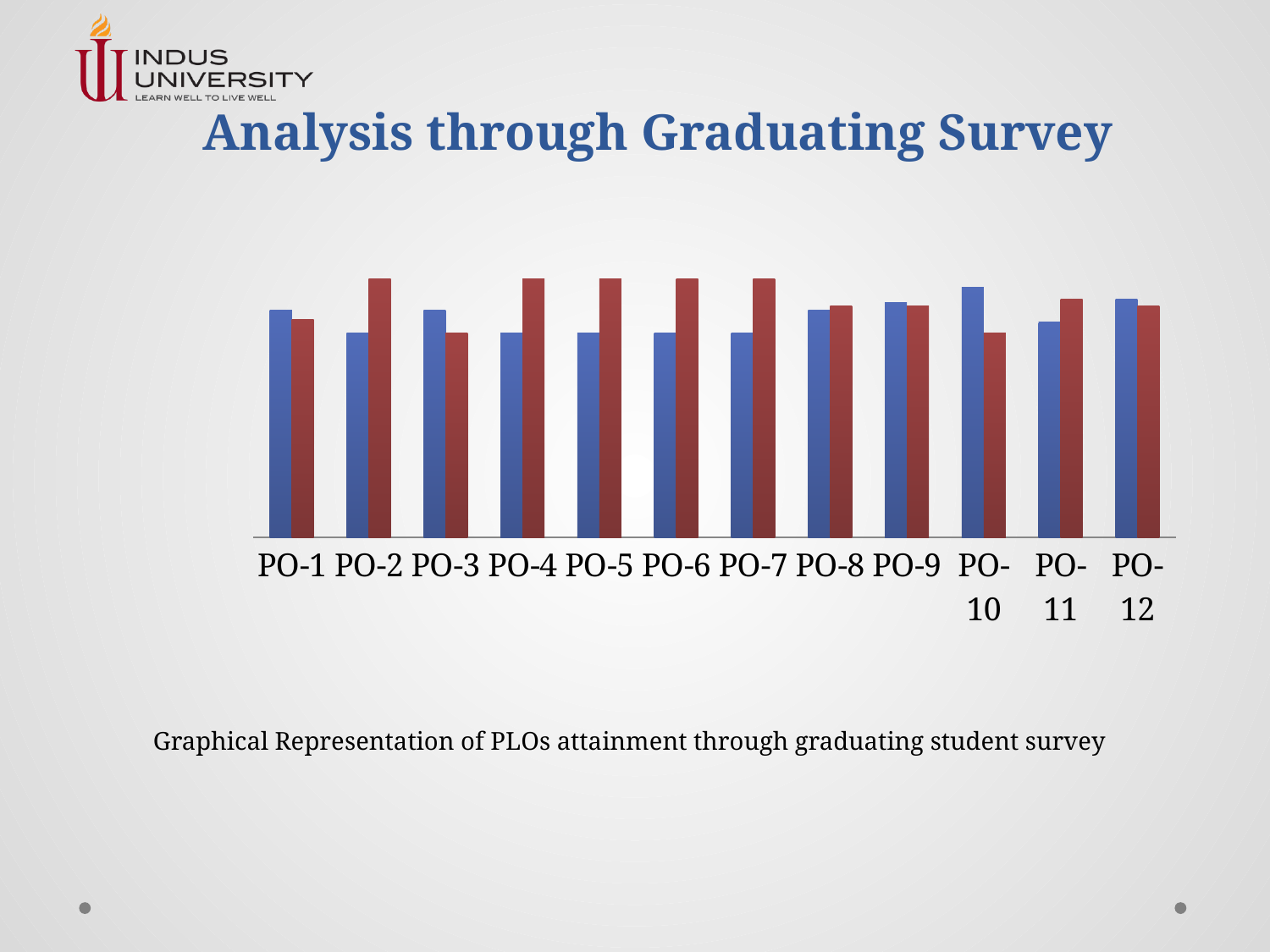
What two colours are used for the bars in the chart? blue and red How many categories (PO-1 to PO-12) are shown on the x axis of the chart? 12 For PO-10, which bar is taller, the blue one or the red one? blue What kind of chart is shown on the slide? bar chart For PO-2, which bar is taller, the blue one or the red one? red For PO-11, which bar is taller, the blue one or the red one? red What is the title of the slide containing the chart? Analysis through Graduating Survey How many data series (bars per category) are plotted in the chart? 2 Which category has the tallest blue bar? PO-10